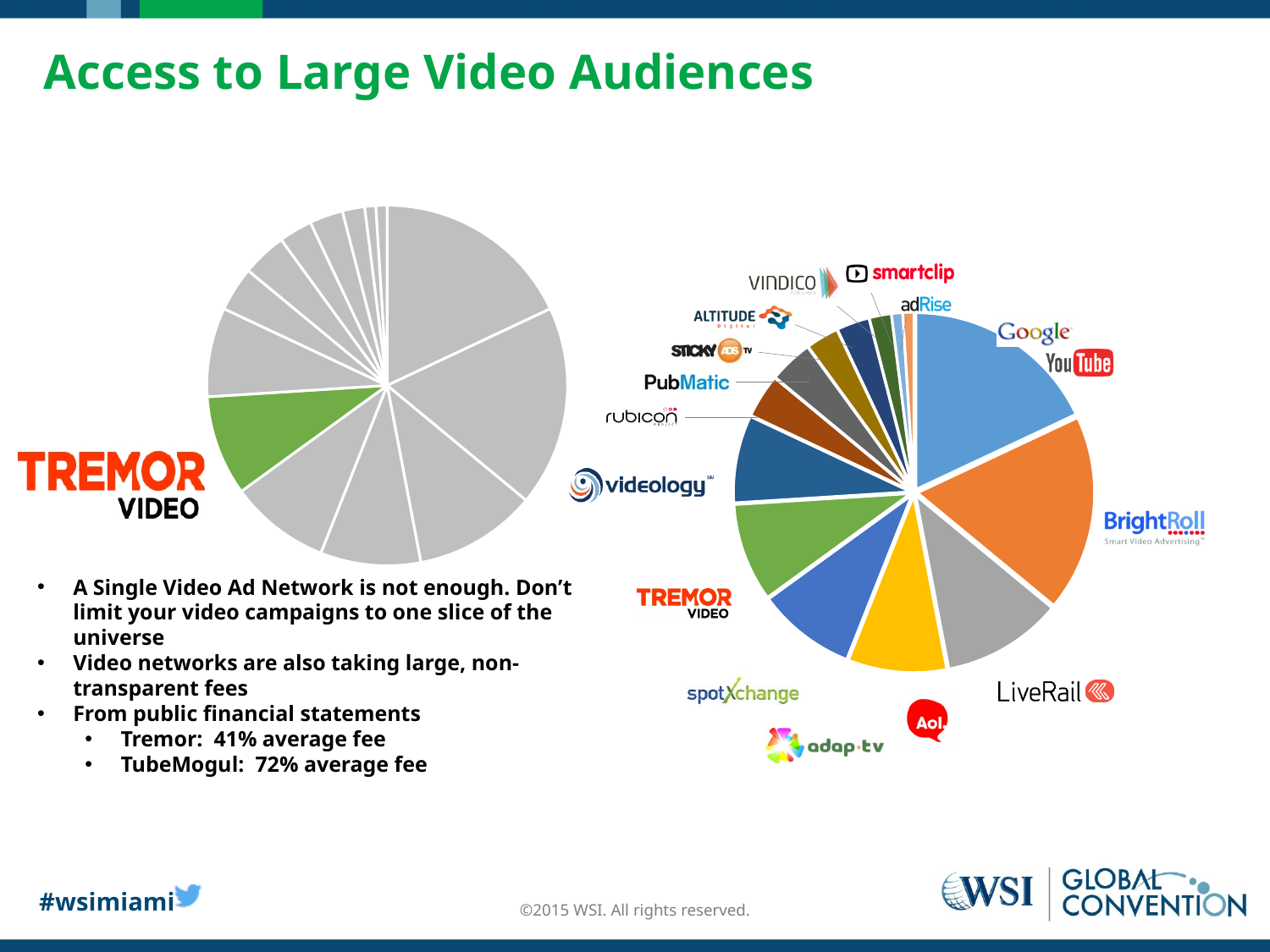
In the left pie chart, is the green slice the largest slice? No In the right pie chart, which slice is larger: Tremor Video or Vindico? Tremor Video In the left pie chart, which company does the green slice represent? Tremor Video In the left pie chart, what colour is the highlighted slice? green In the right pie chart, which slice is larger: Google/YouTube or AOL? Google/YouTube What kind of chart is shown on the left side of the slide? pie chart How many pie charts are on the slide? 2 What kind of chart is shown on the right side of the slide? pie chart In the right pie chart, what colour is the BrightRoll slice? orange